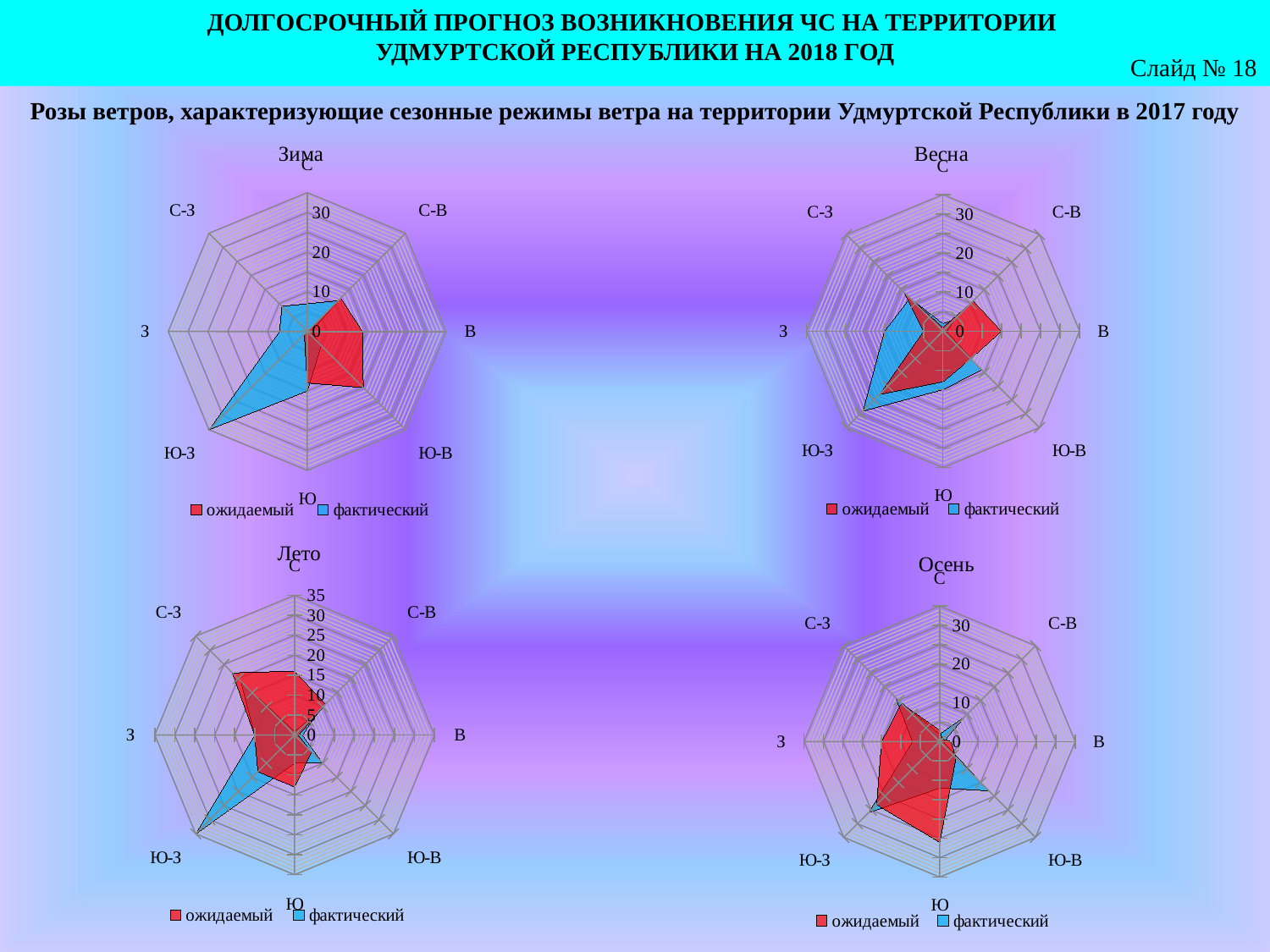
What is the highest axis tick value shown on the "Лето" chart? 35 What are the two legend entries on the "Осень" chart? ожидаемый, фактический On the "Зима" chart, which series has the larger value for Ю-З, "ожидаемый" or "фактический"? фактический How many wind directions (axes) are plotted on the "Лето" chart? 8 On the "Зима" chart, is the "фактический" value for Ю-З greater or less than 20? greater How many series does the legend of the "Весна" chart list? 2 On the "Весна" chart, in which direction does the "фактический" series reach its highest value? Ю-З On the "Лето" chart, in which direction does the "фактический" series reach its highest value? Ю-З On the "Лето" chart, is the "фактический" value for Ю-З greater or less than 25? greater On the "Зима" chart, in which direction does the "фактический" series reach its highest value? Ю-З On the "Лето" chart, which series has the larger value for С-З, "ожидаемый" or "фактический"? ожидаемый What kind of chart is the "Зима" chart? radar chart